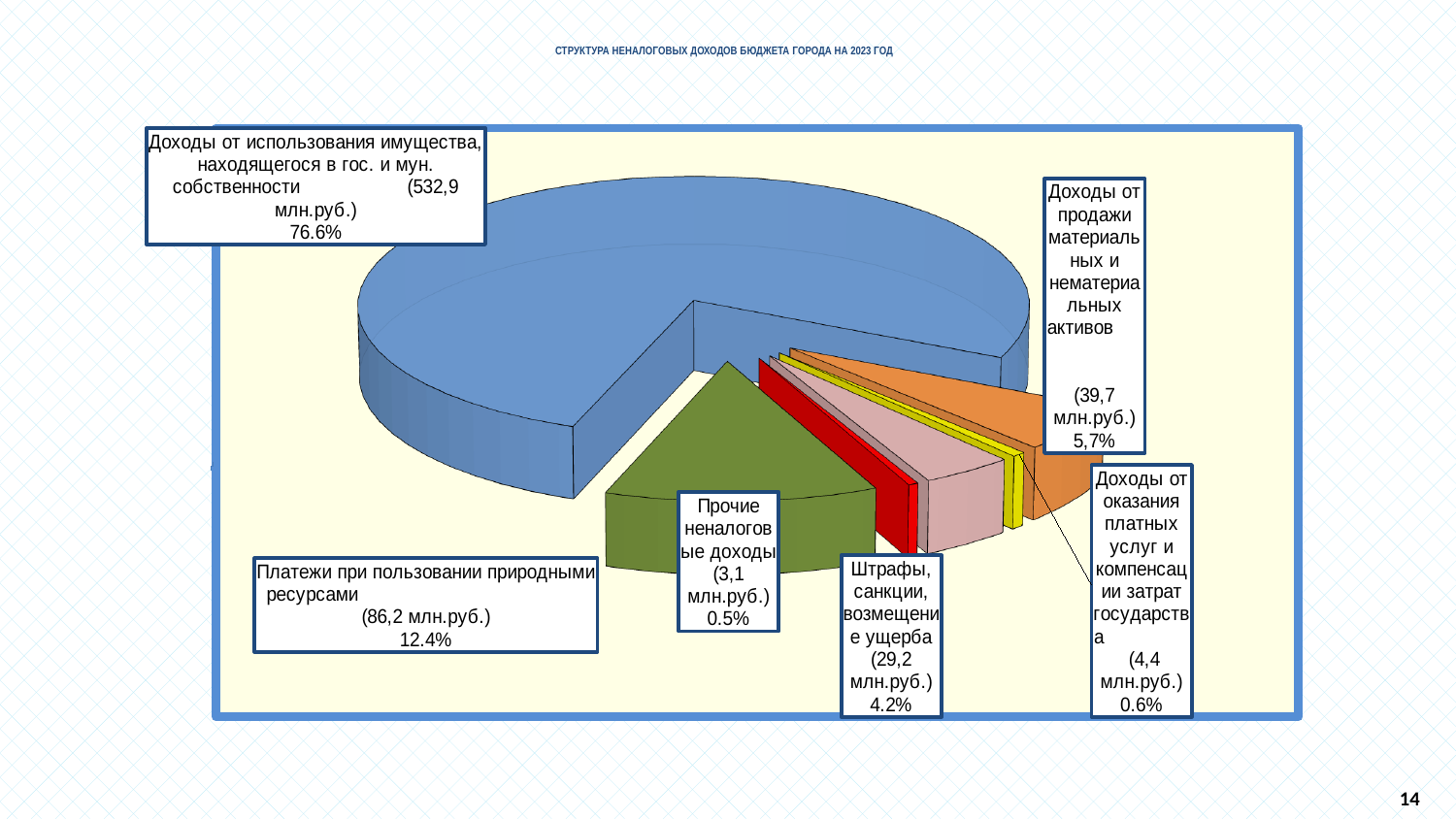
What share of the pie does "Доходы от оказания платных услуг и компенсации затрат государства" represent? 0.6% What is the value for "Платежи при пользовании природными ресурсами"? 86,2 млн.руб. What is the title of the slide's chart? СТРУКТУРА НЕНАЛОГОВЫХ ДОХОДОВ БЮДЖЕТА ГОРОДА НА 2023 ГОД Which is larger: "Доходы от оказания платных услуг и компенсации затрат государства" or "Прочие неналоговые доходы"? Доходы от оказания платных услуг и компенсации затрат государства How many slices does the pie chart have? 6 What share of the pie does "Доходы от использования имущества, находящегося в гос. и мун. собственности" represent? 76.6% What kind of chart is shown on the slide? Pie chart What is the difference in млн.руб. between "Платежи при пользовании природными ресурсами" and "Штрафы, санкции, возмещение ущерба"? 57,0 млн.руб. Which category has the smallest slice of the pie? Прочие неналоговые доходы What share of the pie does "Штрафы, санкции, возмещение ущерба" represent? 4.2% Which category has the largest slice of the pie? Доходы от использования имущества, находящегося в гос. и мун. собственности What is the value for "Доходы от продажи материальных и нематериальных активов"? 39,7 млн.руб.